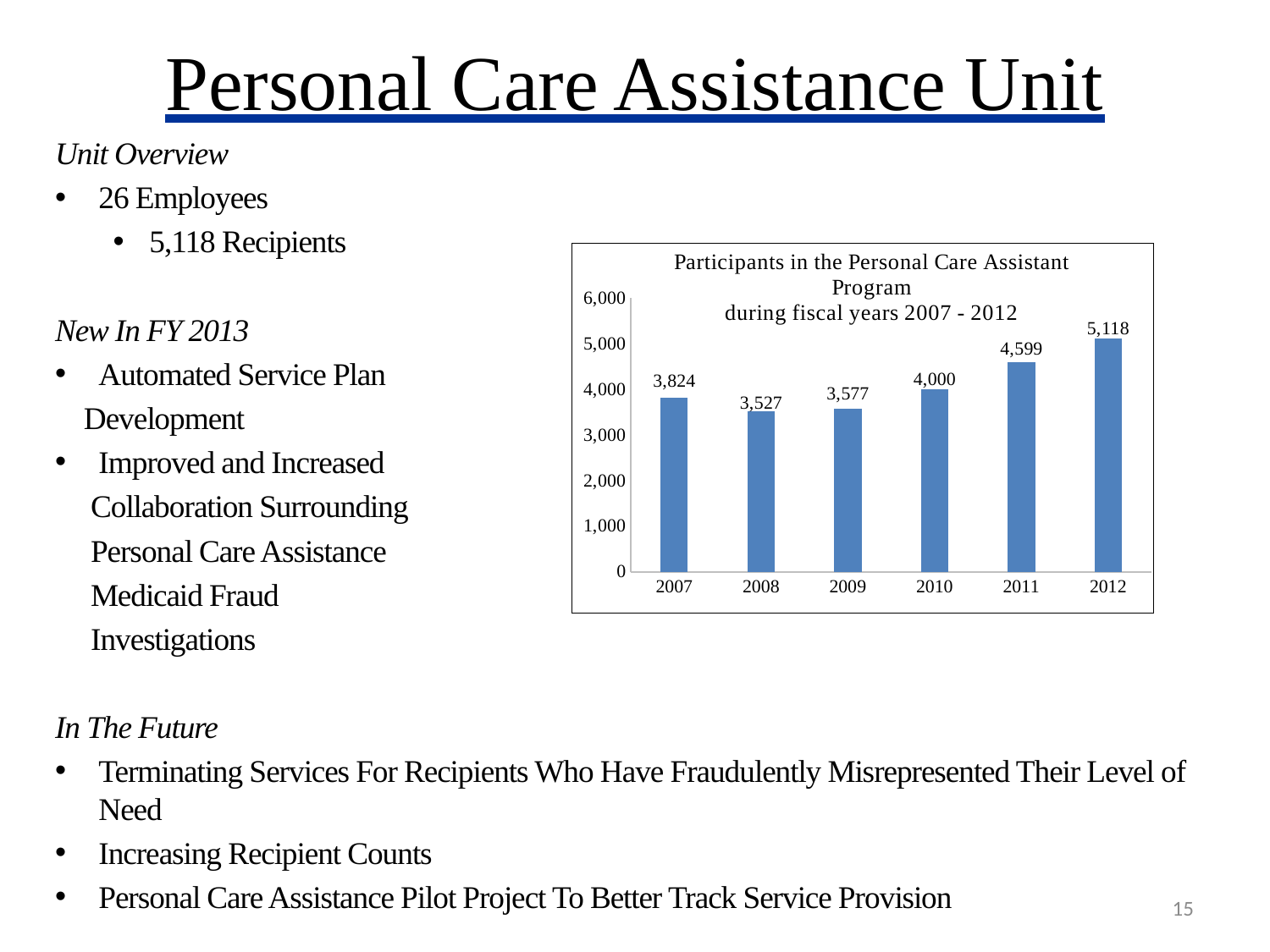
Is the value for 2011 greater or less than 4,000? greater Which fiscal year has the highest number of participants in the Personal Care Assistant Program? 2012 What is the difference in participants between 2007 and 2008? 297 Which year had more participants, 2007 or 2009? 2007 What is the overall trend in participants from 2008 to 2012? Rising What kind of chart is used to show participants in the Personal Care Assistant Program? Bar chart What is the difference in participants between 2012 and 2011? 519 What is the number of participants in the Personal Care Assistant Program in 2008? 3,527 What is the number of participants in the Personal Care Assistant Program in 2012? 5,118 What is the number of participants in the Personal Care Assistant Program in 2010? 4,000 Which fiscal year has the lowest number of participants in the Personal Care Assistant Program? 2008 How many fiscal years are shown in the chart? 6